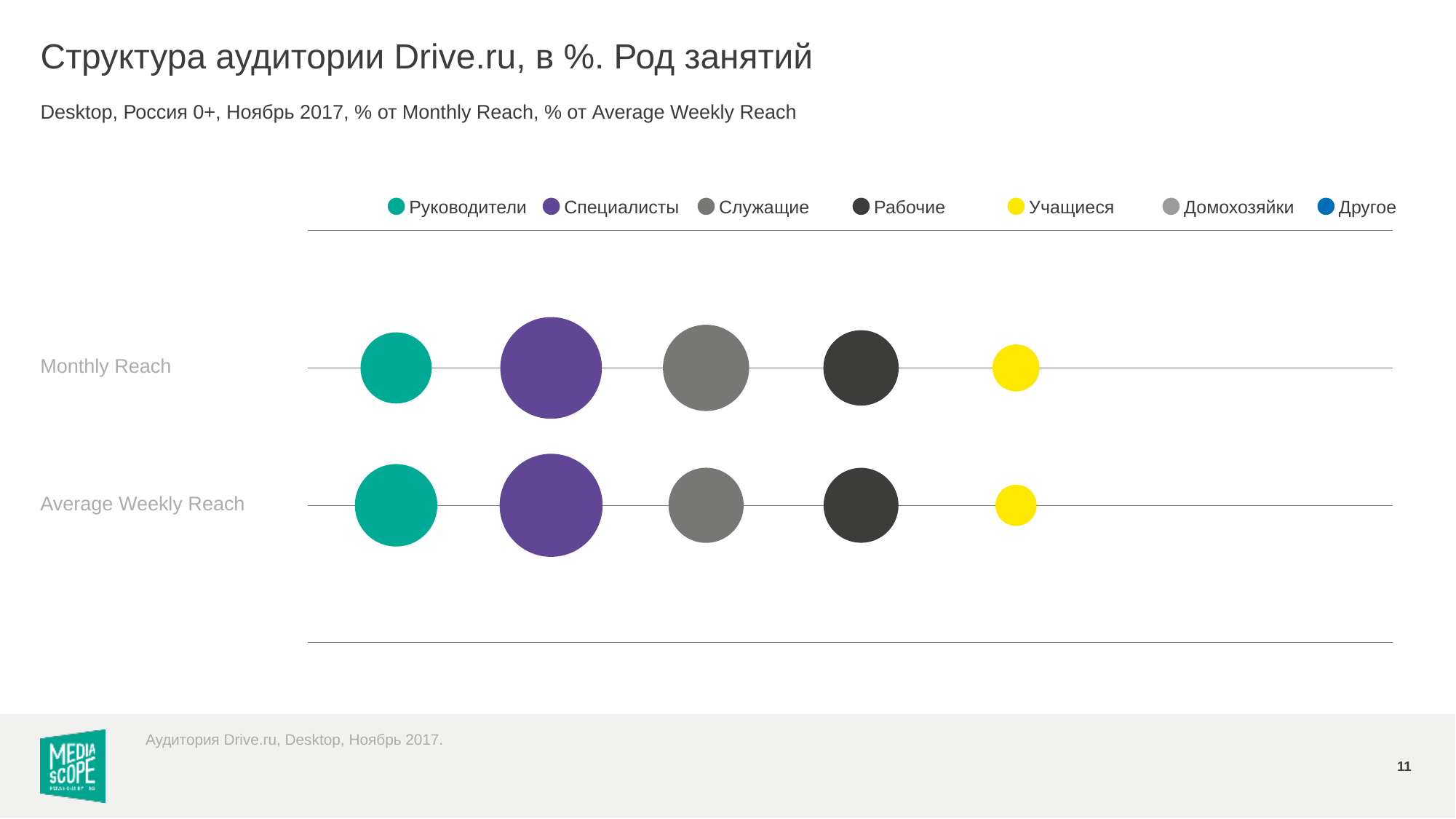
Among the visible bubbles in the Monthly Reach row, which occupation group has the smallest? Учащиеся Which occupation group has the largest bubble in the Monthly Reach row? Специалисты Among the visible bubbles in the Average Weekly Reach row, which occupation group has the smallest? Учащиеся Which colour represents Специалисты in the legend? purple For Служащие, which row has the larger bubble: Monthly Reach or Average Weekly Reach? Monthly Reach What is the title of the chart slide? Структура аудитории Drive.ru, в %. Род занятий How many rows (reach metrics) are plotted on the chart? 2 For Учащиеся, which row has the larger bubble: Monthly Reach or Average Weekly Reach? Monthly Reach What kind of chart is shown on the slide? bubble chart In the Monthly Reach row, which bubble is larger: Специалисты or Руководители? Специалисты Which occupation group has the largest bubble in the Average Weekly Reach row? Специалисты How many series does the legend list? 7